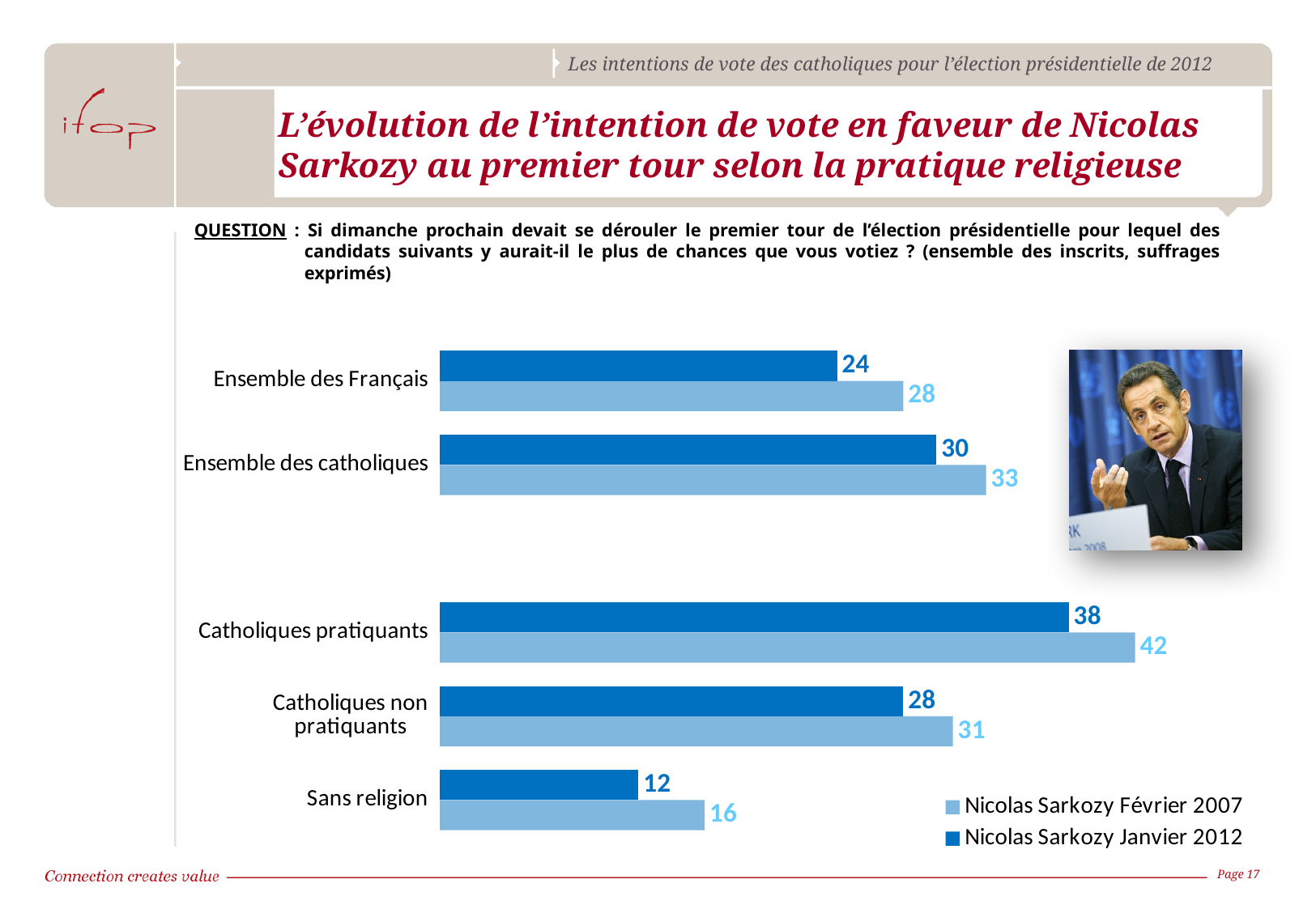
Which series is shown in the lighter blue colour? Nicolas Sarkozy Février 2007 Which is larger for Catholiques pratiquants: the Février 2007 value or the Janvier 2012 value? Février 2007 What is the difference between the Février 2007 and Janvier 2012 values for Catholiques non pratiquants? 3 What is the value for Sans religion in the Nicolas Sarkozy Février 2007 series? 16 What is the value for Ensemble des catholiques in the Nicolas Sarkozy Février 2007 series? 33 How many categories are shown on the chart? 5 How many series does the legend list? 2 What is the value for Catholiques pratiquants in the Nicolas Sarkozy Janvier 2012 series? 38 Which category has the lowest value in the Nicolas Sarkozy Février 2007 series? Sans religion What is the difference between the Février 2007 and Janvier 2012 values for Ensemble des Français? 4 Which category has the highest value in the Nicolas Sarkozy Janvier 2012 series? Catholiques pratiquants What kind of chart is shown on the slide? Bar chart